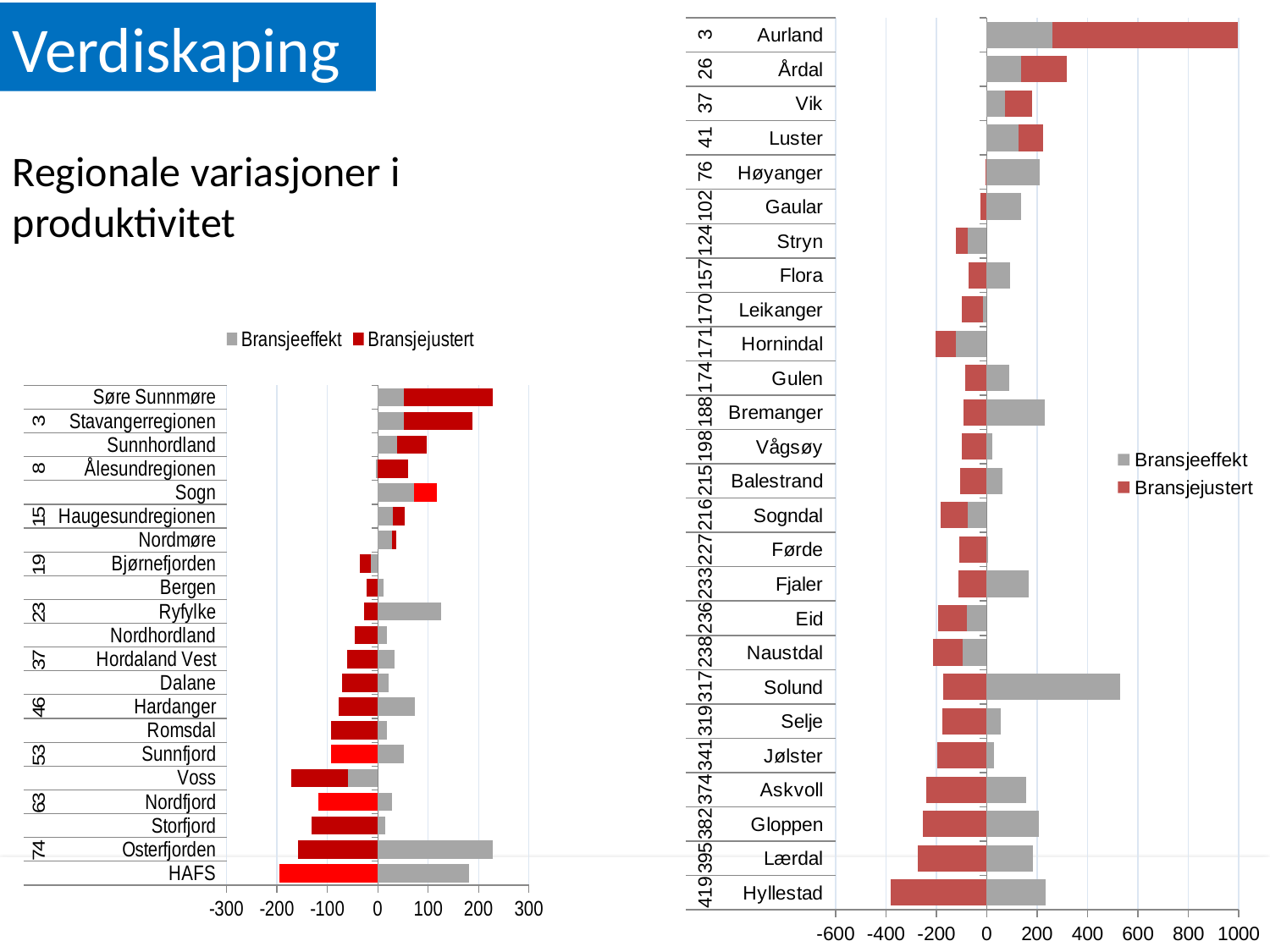
In the right chart, which category has the lowest Bransjejustert value? Hyllestad In the right chart, which category has the highest Bransjeeffekt value? Solund What kind of chart is the chart on the right of the slide (Aurland to Hyllestad)? bar chart In the left chart, is the Bransjejustert value for HAFS greater or less than -100? less In the right chart, which has the larger Bransjejustert value, Aurland or Årdal? Aurland In the right chart, is the Bransjejustert value for Aurland greater or less than 600? greater How many categories are plotted in the left chart (Søre Sunnmøre to HAFS)? 21 How many series does the legend of the left chart (Søre Sunnmøre to HAFS) list? 2 In the left chart, which colour represents the Bransjejustert series? red How many categories are plotted in the right chart (Aurland to Hyllestad)? 26 In the right chart, is the Bransjejustert value for Hyllestad greater or less than -200? less In the right chart, which category has the highest Bransjejustert value? Aurland